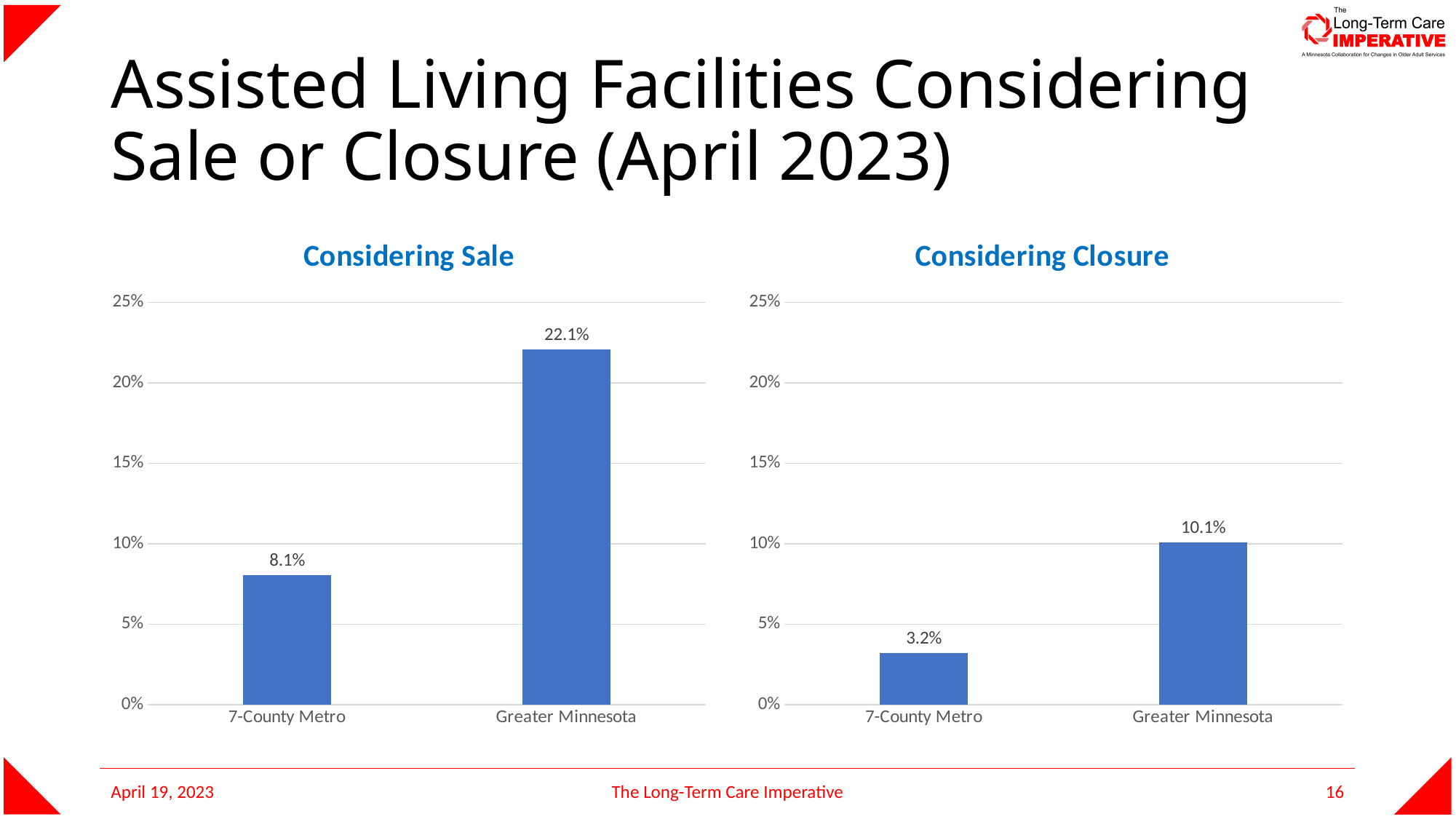
In the 'Considering Closure' chart, what is the difference between the Greater Minnesota and 7-County Metro values? 6.9% In the 'Considering Sale' chart, which category has the highest value? Greater Minnesota In the 'Considering Closure' chart, what is the value for 7-County Metro? 3.2% In the 'Considering Sale' chart, what is the value for Greater Minnesota? 22.1% What type of chart is the 'Considering Sale' chart? bar chart In the 'Considering Closure' chart, what is the value for Greater Minnesota? 10.1% In the 'Considering Sale' chart, what is the value for 7-County Metro? 8.1% In the 'Considering Sale' chart, is the value for Greater Minnesota greater or less than 20%? greater In the 'Considering Sale' chart, what is the difference between the Greater Minnesota and 7-County Metro values? 14.0% Is the Greater Minnesota value in the 'Considering Sale' chart larger or smaller than the Greater Minnesota value in the 'Considering Closure' chart? larger In the 'Considering Closure' chart, which category has the lowest value? 7-County Metro How many categories are shown in the 'Considering Closure' chart? 2